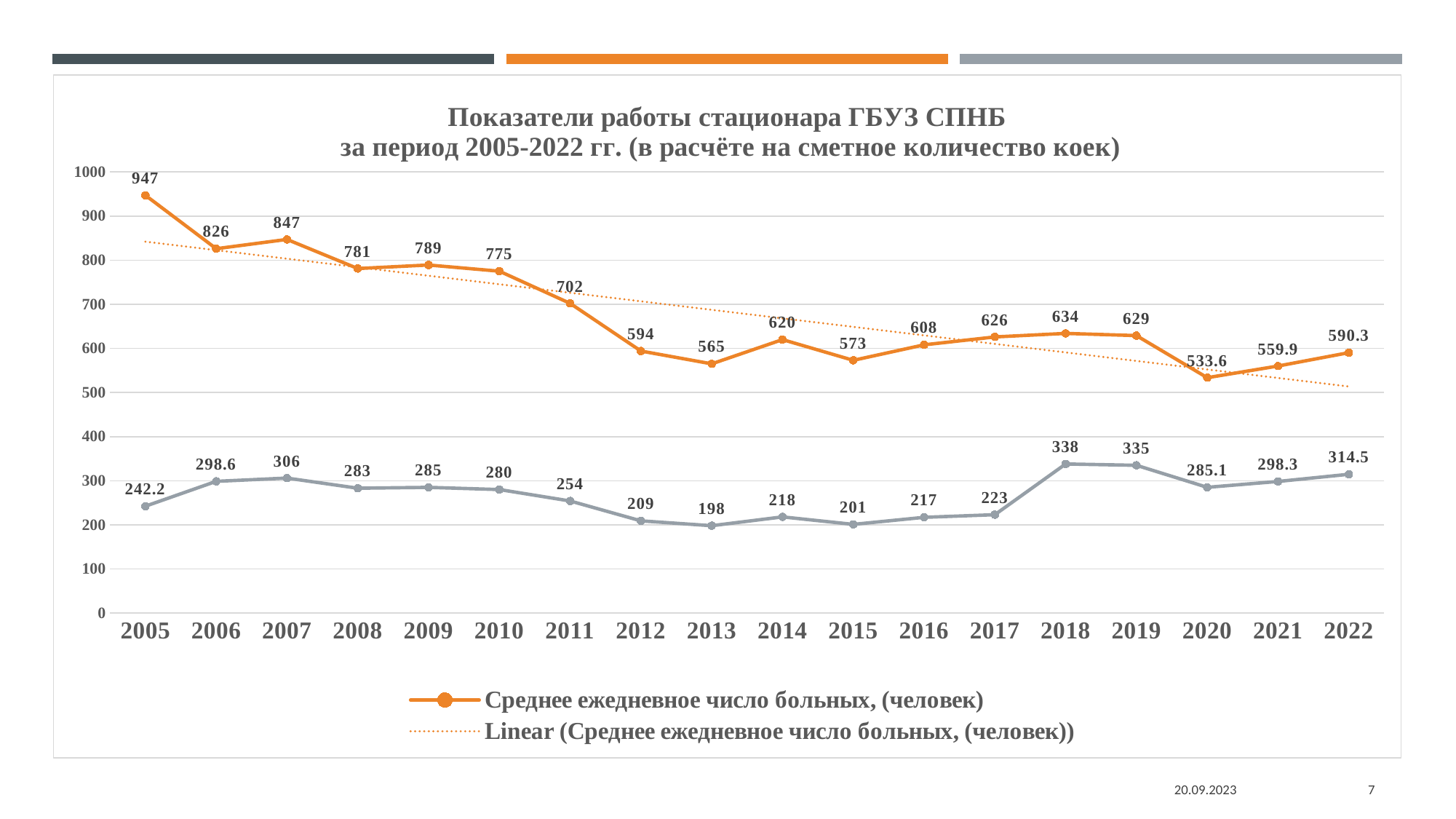
In which year is 'Среднее ежедневное число больных, (человек)' lowest? 2020 What is the difference between the 'Среднее ежедневное число больных, (человек)' values for 2005 and 2006? 121 What is the value of 'Среднее ежедневное число больных, (человек)' in 2005? 947 How many entries does the legend list? 2 What is the value of 'Среднее ежедневное число больных, (человек)' in 2020? 533.6 In which year is 'Среднее ежедневное число больных, (человек)' highest? 2005 What is the value of the lower grey line in 2018? 338 How many years are shown on the x axis? 18 Does 'Среднее ежедневное число больных, (человек)' generally rise or fall from 2005 to 2022? fall What type of chart is shown on the slide? line chart What is the value of 'Среднее ежедневное число больных, (человек)' in 2022? 590.3 Which year has a larger value for 'Среднее ежедневное число больных, (человек)': 2011 or 2012? 2011